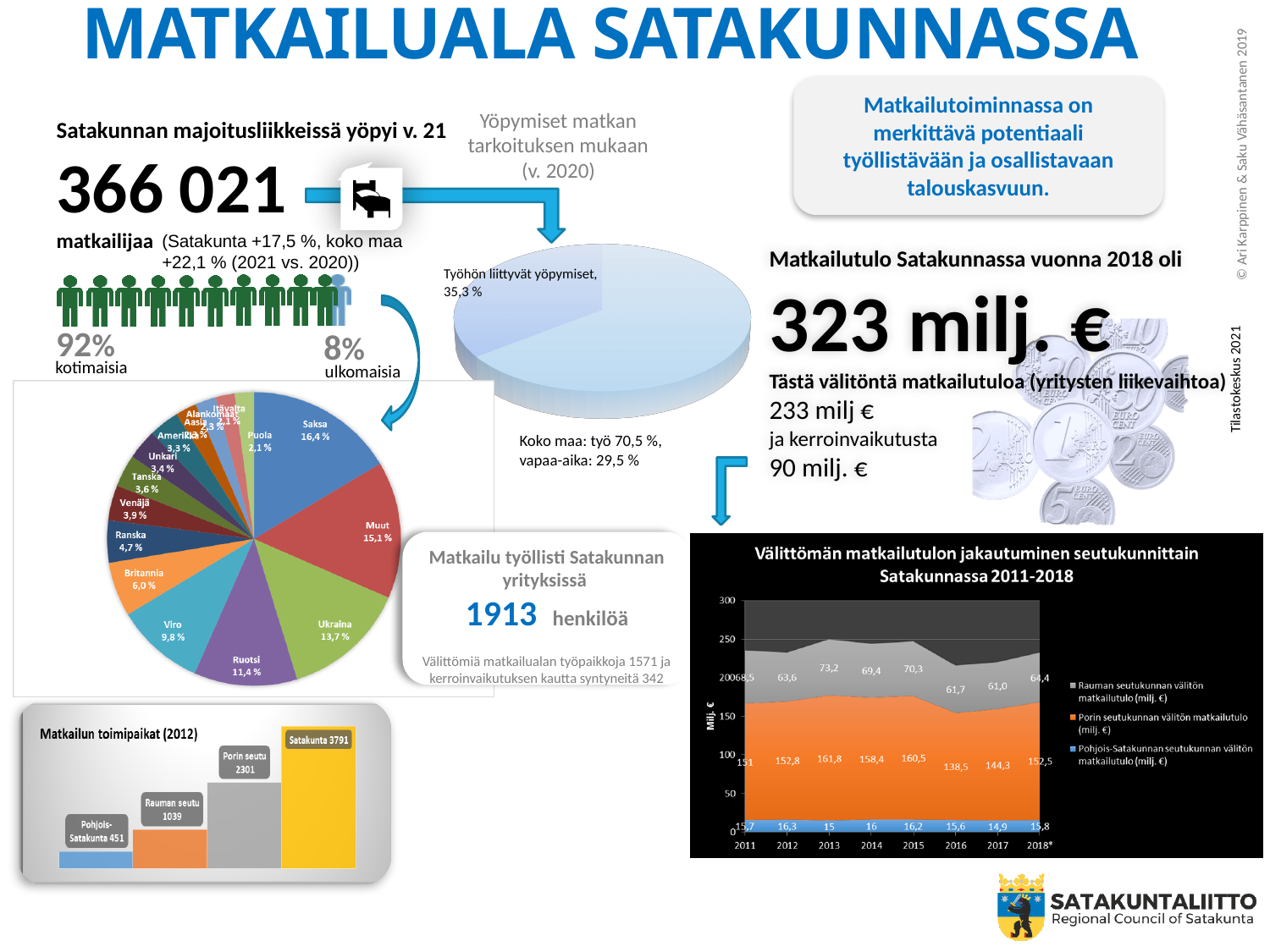
In the chart 'Välittömän matkailutulon jakautuminen seutukunnittain Satakunnassa 2011-2018', what is the value for Porin seutukunta in 2013? 161,8 In the pie chart of foreign visitors by country (left), which is larger, Viro or Ruotsi? Ruotsi In the pie chart of foreign visitors by country (left), what share does Britannia have? 6,0 % In the chart 'Välittömän matkailutulon jakautuminen seutukunnittain Satakunnassa 2011-2018', what is the total of the three series in 2011? 235,2 In the 'Matkailun toimipaikat (2012)' bar chart, what is the value for Porin seutu? 2301 In the 'Matkailun toimipaikat (2012)' bar chart, what is the difference between Satakunta and Rauman seutu? 2752 In the chart 'Välittömän matkailutulon jakautuminen seutukunnittain Satakunnassa 2011-2018', how many series does the legend list? 3 In the chart 'Välittömän matkailutulon jakautuminen seutukunnittain Satakunnassa 2011-2018', what is the value for Rauman seutukunta in 2017? 61,0 In the pie chart 'Yöpymiset matkan tarkoituksen mukaan (v. 2020)', what share is 'Työhön liittyvät yöpymiset'? 35,3 % What kind of chart is 'Matkailun toimipaikat (2012)'? bar chart In the 'Matkailun toimipaikat (2012)' bar chart, which category has the lowest value? Pohjois-Satakunta In the pie chart of foreign visitors by country (left), what share does Saksa have? 16,4 %